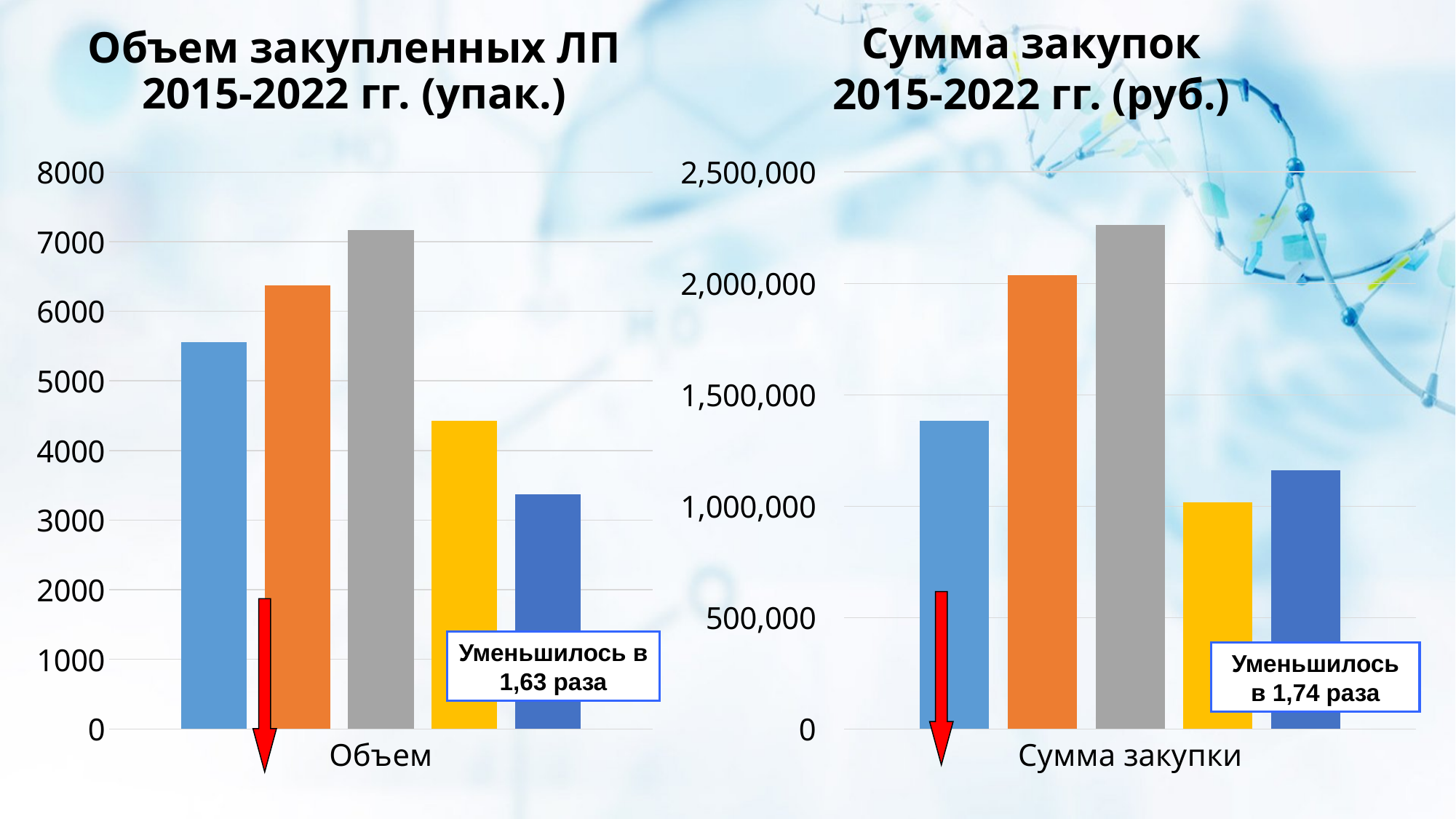
In the right chart "Сумма закупок 2015-2022 гг. (руб.)", which coloured bar is the shortest? the yellow bar In the right chart "Сумма закупок 2015-2022 гг. (руб.)", which coloured bar is the tallest? the gray bar What does the annotation box on the left chart "Объем закупленных ЛП 2015-2022 гг. (упак.)" say? Уменьшилось в 1,63 раза In the left chart "Объем закупленных ЛП 2015-2022 гг. (упак.)", which coloured bar is the tallest? the gray bar In the left chart "Объем закупленных ЛП 2015-2022 гг. (упак.)", is the value of the yellow bar greater or less than 5000? less In the left chart "Объем закупленных ЛП 2015-2022 гг. (упак.)", is the value of the gray bar greater or less than 7000? greater In the left chart "Объем закупленных ЛП 2015-2022 гг. (упак.)", which coloured bar is the shortest? the dark blue bar What is the category label shown on the x axis of the right chart "Сумма закупок 2015-2022 гг. (руб.)"? Сумма закупки What kind of chart is the left chart titled "Объем закупленных ЛП 2015-2022 гг. (упак.)"? bar chart How many bars are plotted in the left chart "Объем закупленных ЛП 2015-2022 гг. (упак.)"? 5 In the left chart "Объем закупленных ЛП 2015-2022 гг. (упак.)", which is taller, the orange bar or the light blue bar? the orange bar In the right chart "Сумма закупок 2015-2022 гг. (руб.)", is the value of the light blue bar greater or less than 1,500,000? less